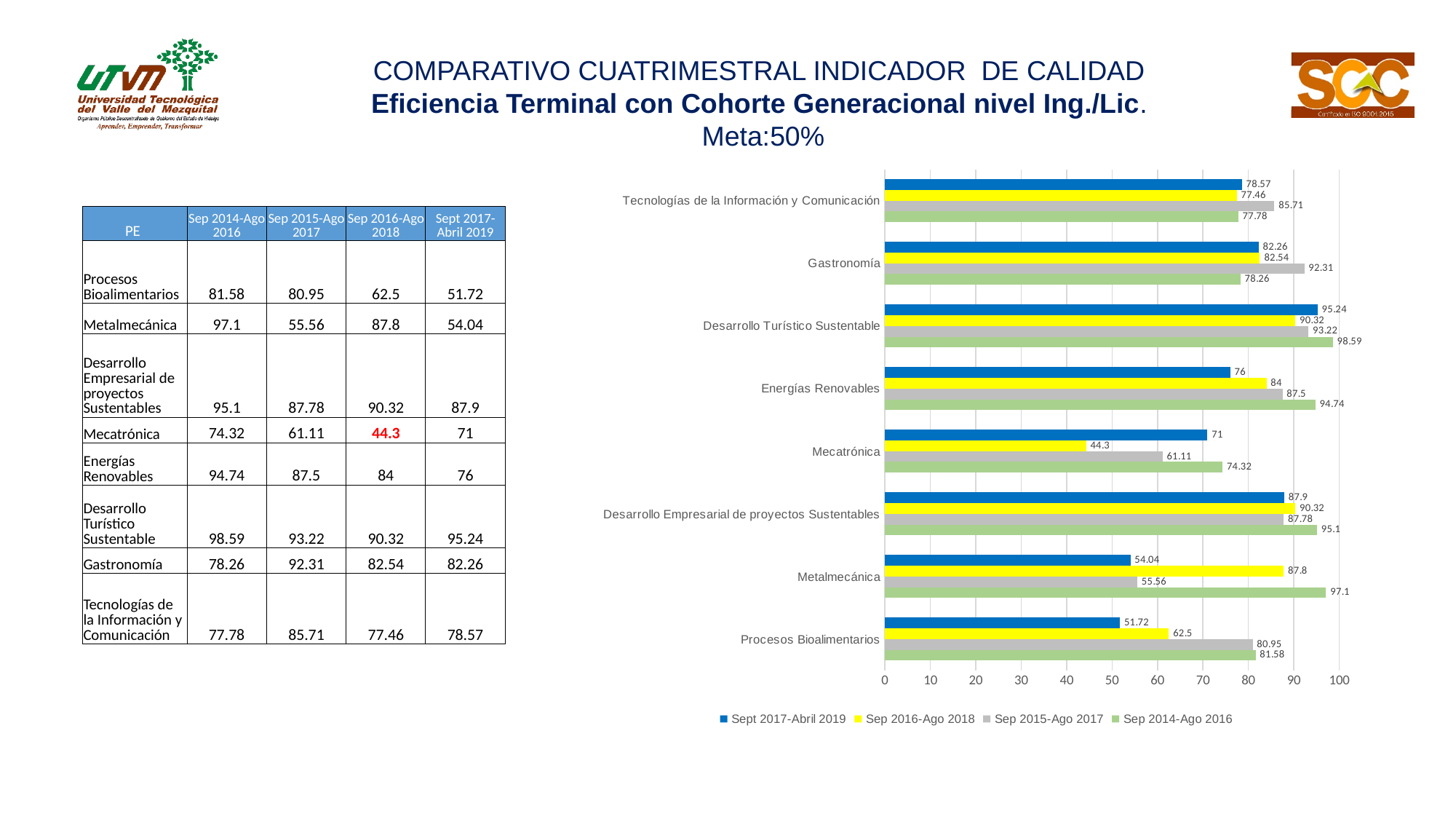
What is the value for Mecatrónica in the Sep 2016-Ago 2018 series? 44.3 For Metalmecánica, what is the difference between the Sep 2014-Ago 2016 value and the Sept 2017-Abril 2019 value? 43.06 How many categories (programs) are shown on the chart? 8 Is the value for Procesos Bioalimentarios in the Sept 2017-Abril 2019 series greater or less than 60? less What is the value for Metalmecánica in the Sep 2014-Ago 2016 series? 97.1 How many series does the chart legend list? 4 Which category has the lowest value in the Sep 2016-Ago 2018 series? Mecatrónica What is the value for Energías Renovables in the Sep 2015-Ago 2017 series? 87.5 For Gastronomía, which series has the larger value: Sep 2015-Ago 2017 or Sep 2014-Ago 2016? Sep 2015-Ago 2017 What kind of chart is shown on the slide? bar chart What colour represents the Sept 2017-Abril 2019 series in the chart? blue Which category has the highest value in the Sept 2017-Abril 2019 series? Desarrollo Turístico Sustentable